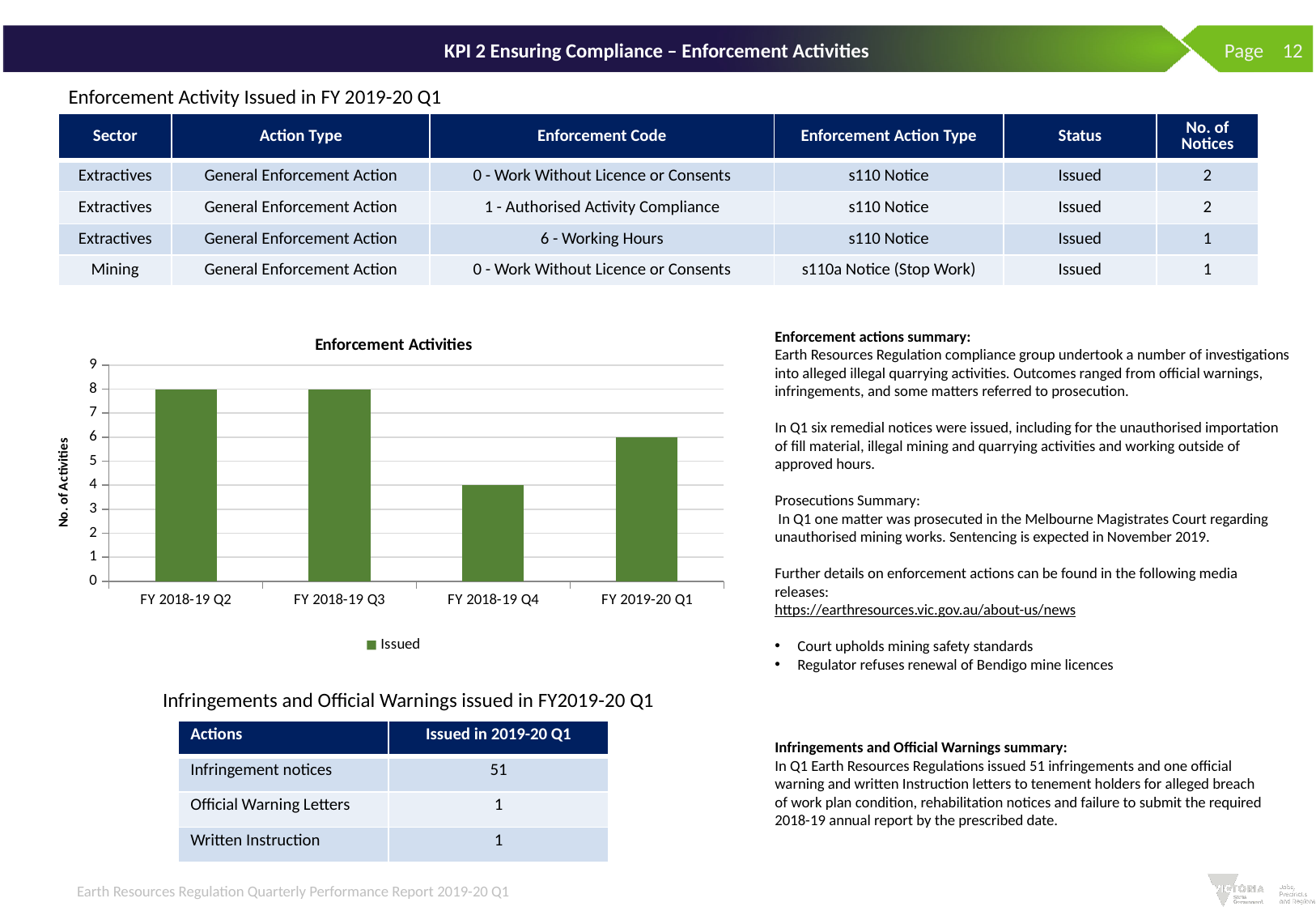
In the Enforcement Activities chart, what is the value for FY 2018-19 Q3? 8 In the Enforcement Activities chart, which is larger: FY 2019-20 Q1 or FY 2018-19 Q4? FY 2019-20 Q1 In the Enforcement Activities chart, is the value for FY 2018-19 Q4 greater or less than 5? less How many series does the legend of the Enforcement Activities chart list? 1 In the Enforcement Activities chart, how many categories are shown on the x axis? 4 In the Enforcement Activities chart, what is the value for FY 2019-20 Q1? 6 What type of chart is the Enforcement Activities chart? bar chart In the Enforcement Activities chart, what is the difference between FY 2018-19 Q3 and FY 2018-19 Q4? 4 In the Enforcement Activities chart, what is the value for FY 2018-19 Q4? 4 What is the legend entry shown in the Enforcement Activities chart? Issued In the Enforcement Activities chart, does the value rise or fall from FY 2018-19 Q3 to FY 2018-19 Q4? fall In the Enforcement Activities chart, which category has the lowest value? FY 2018-19 Q4